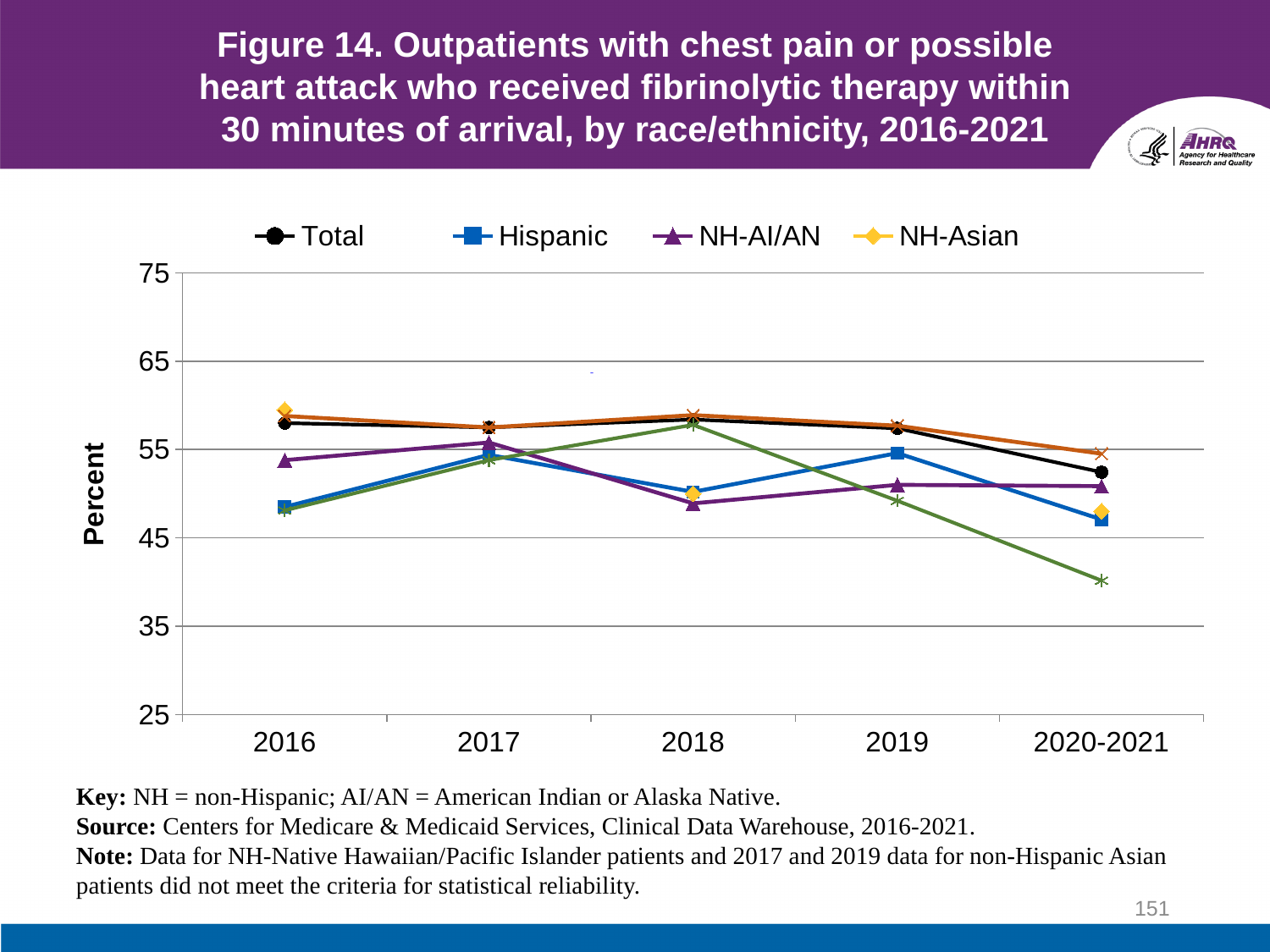
In 2016, which is larger, the value for Total or the value for Hispanic? Total Is the value for Hispanic in 2016 greater or less than 45? greater Is the value for NH-Asian in 2020-2021 greater or less than 55? less In 2020-2021, which is larger, the value for NH-AI/AN or the value for Hispanic? NH-AI/AN Does the Total line rise or fall from 2019 to 2020-2021? fall Is the value for Total in 2020-2021 greater or less than 55? less How many series does the legend list? 4 What kind of chart is shown on the slide? line chart What is the label on the y axis? Percent How many time periods are shown on the x axis? 5